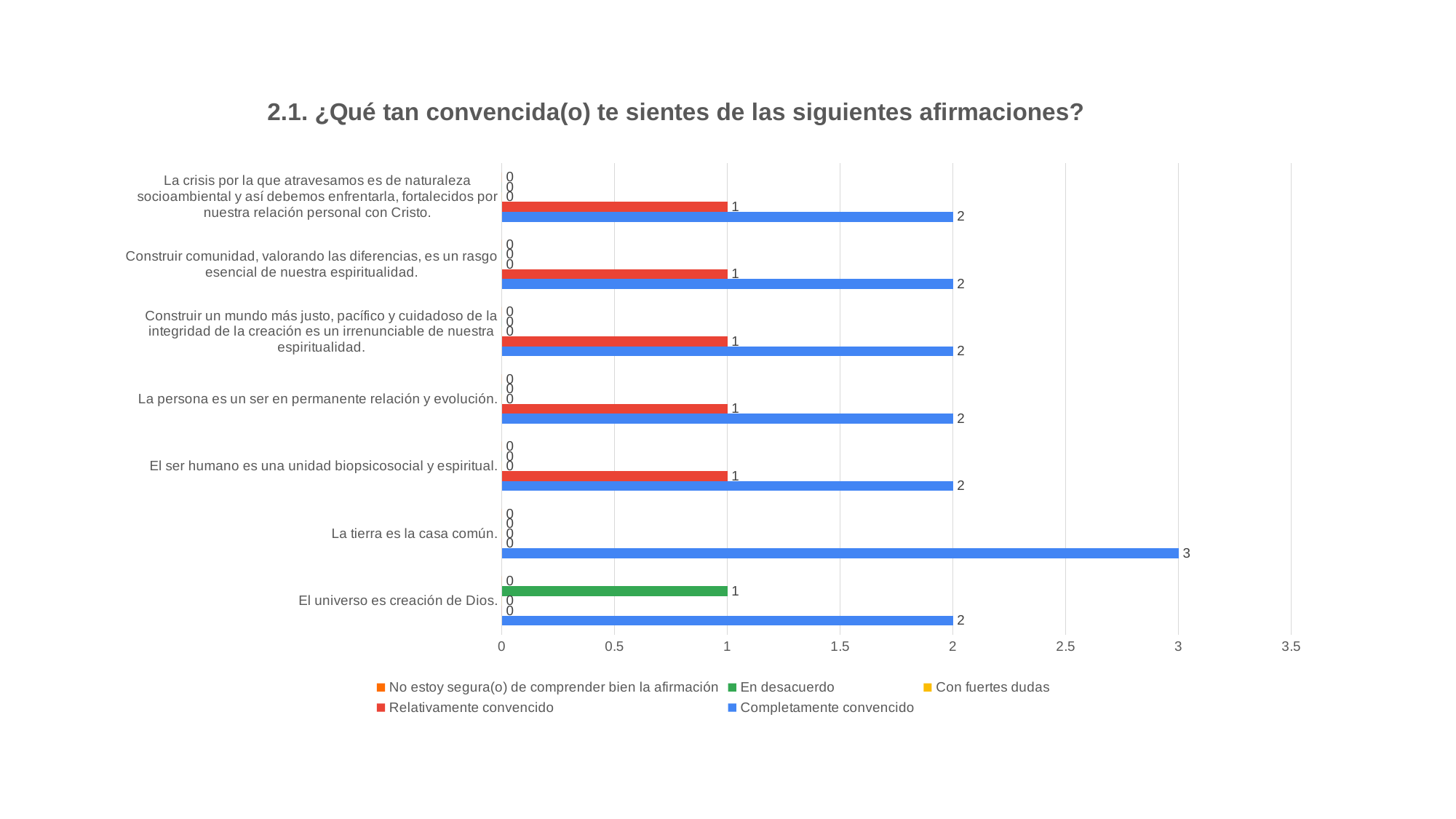
What is the value of "En desacuerdo" for "El universo es creación de Dios."? 1 What is the title of the chart? 2.1. ¿Qué tan convencida(o) te sientes de las siguientes afirmaciones? What kind of chart is shown on the slide? bar chart How many statements (categories) are shown on the chart? 7 What is the difference between the "Completamente convencido" value for "La tierra es la casa común." and for "El universo es creación de Dios."? 1 What is the value of "Relativamente convencido" for "La persona es un ser en permanente relación y evolución."? 1 What is the value of "Completamente convencido" for "El ser humano es una unidad biopsicosocial y espiritual."? 2 What is the total of all series for "La crisis por la que atravesamos es de naturaleza socioambiental..."? 3 What is the value of "Completamente convencido" for "La tierra es la casa común."? 3 How many series does the legend list? 5 Which is larger for "El universo es creación de Dios.": "En desacuerdo" or "Completamente convencido"? Completamente convencido Which statement has the highest value for "Completamente convencido"? La tierra es la casa común.